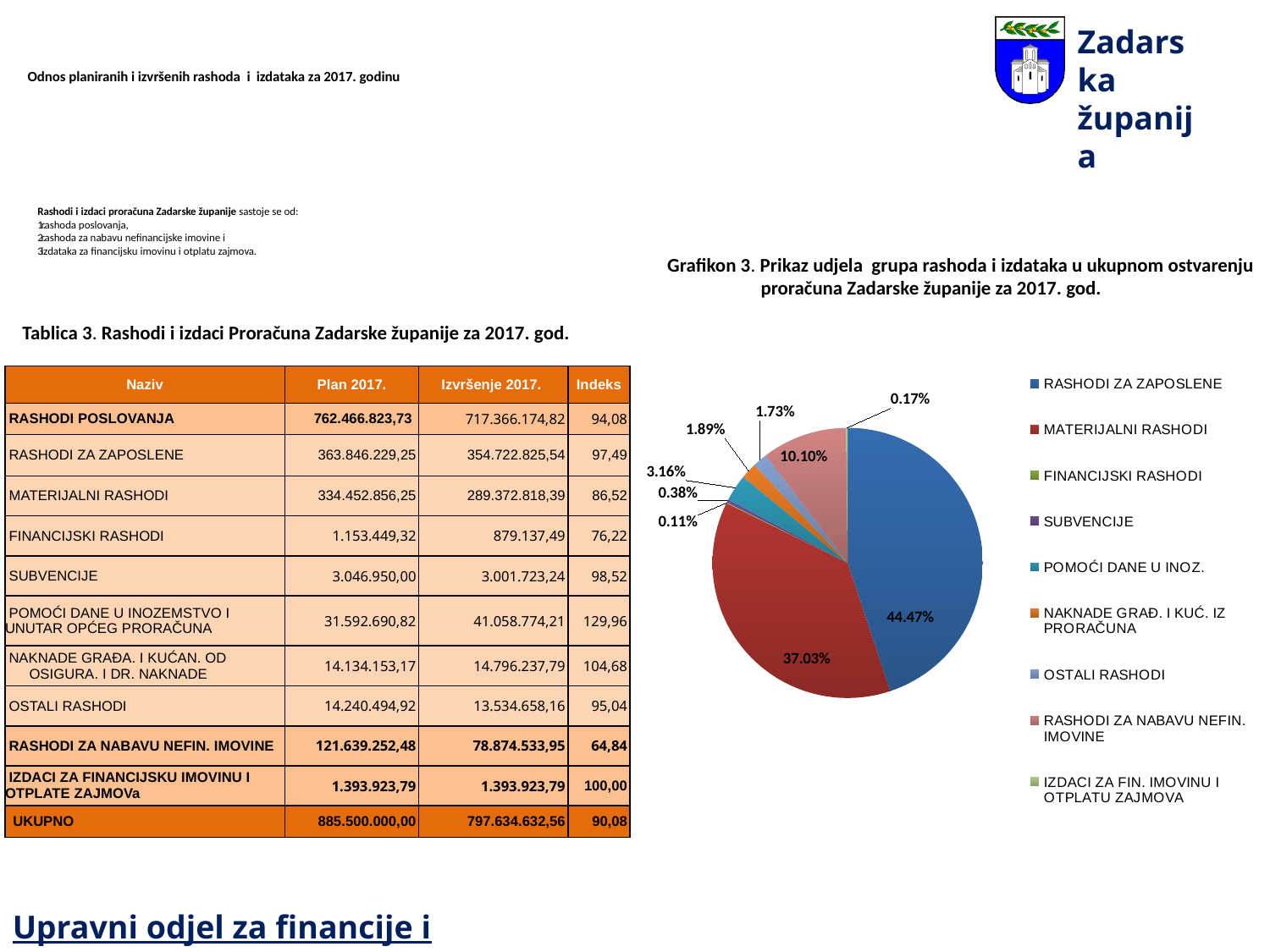
In the pie chart, what share is shown for RASHODI ZA NABAVU NEFIN. IMOVINE? 10.10% Which category has the smallest slice in the pie chart? FINANCIJSKI RASHODI In the pie chart, what share is shown for SUBVENCIJE? 0.38% How many categories does the legend of the pie chart list? 9 What type of chart is shown in Grafikon 3? pie chart In the pie chart, what share is shown for RASHODI ZA ZAPOSLENE? 44.47% In the pie chart, what share is shown for MATERIJALNI RASHODI? 37.03% In the pie chart, what is the difference in percentage points between RASHODI ZA ZAPOSLENE and MATERIJALNI RASHODI? 7.44 In the pie chart, which is larger: the share for OSTALI RASHODI or the share for NAKNADE GRAĐ. I KUĆ. IZ PRORAČUNA? NAKNADE GRAĐ. I KUĆ. IZ PRORAČUNA In the pie chart, what share is shown for POMOĆI DANE U INOZ.? 3.16% What is the title of the pie chart? Grafikon 3. Prikaz udjela grupa rashoda i izdataka u ukupnom ostvarenju proračuna Zadarske županije za 2017. god. Which category has the largest slice in the pie chart? RASHODI ZA ZAPOSLENE